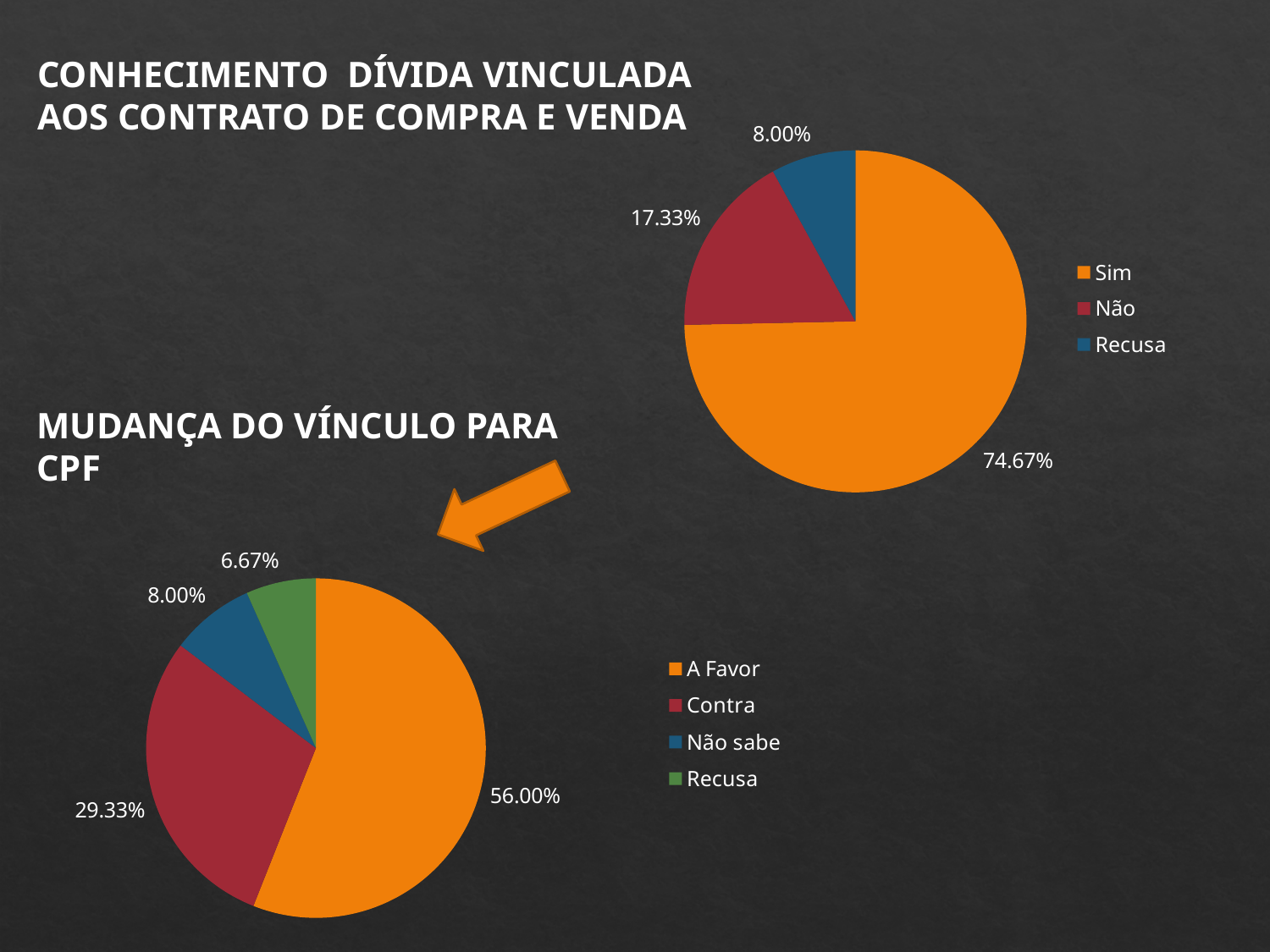
In the bottom-left pie chart (Mudança do vínculo para CPF), which is larger, Não sabe or Recusa? Não sabe In the top-right pie chart (Conhecimento dívida vinculada aos contrato de compra e venda), what share is labelled for Sim? 74.67% In the top-right pie chart (Conhecimento dívida vinculada aos contrato de compra e venda), which category has the smallest slice? Recusa In the top-right pie chart (Conhecimento dívida vinculada aos contrato de compra e venda), what is the difference between the Sim and Não shares? 57.34% In the bottom-left pie chart (Mudança do vínculo para CPF), how many categories does the legend list? 4 What type of chart is used for both charts on the slide? Pie chart In the bottom-left pie chart (Mudança do vínculo para CPF), which category has the largest slice? A Favor In the bottom-left pie chart (Mudança do vínculo para CPF), what share is labelled for Recusa? 6.67% In the bottom-left pie chart (Mudança do vínculo para CPF), what share is labelled for A Favor? 56.00% In the top-right pie chart (Conhecimento dívida vinculada aos contrato de compra e venda), what share is labelled for Não? 17.33% In the bottom-left pie chart (Mudança do vínculo para CPF), what share is labelled for Contra? 29.33% In the top-right pie chart (Conhecimento dívida vinculada aos contrato de compra e venda), how many categories does the legend list? 3